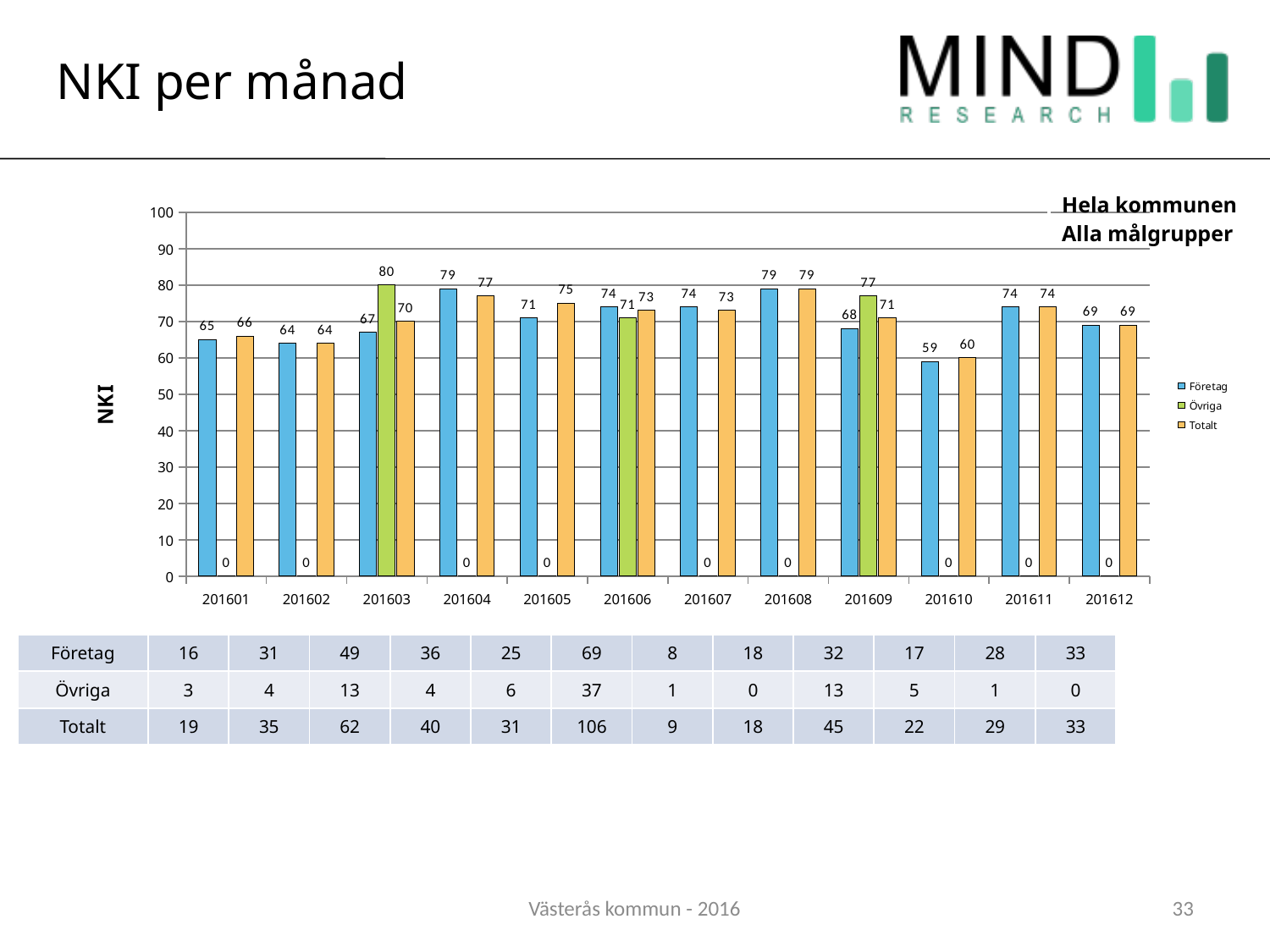
What is the Företag value for 201604? 79 What is the difference between the Totalt value and the Företag value for 201605? 4 Is the Totalt value for 201603 greater or less than 60? greater How many series does the legend list? 3 What kind of chart is shown on the slide? bar chart What is the Övriga value for 201609? 77 In which month is the Företag value lowest? 201610 What is the Övriga value for 201603? 80 What is the Totalt value for 201610? 60 How many months are shown on the x axis of the chart? 12 In which month is the Totalt value highest? 201608 Which is larger, the Företag value for 201601 or for 201602? 201601